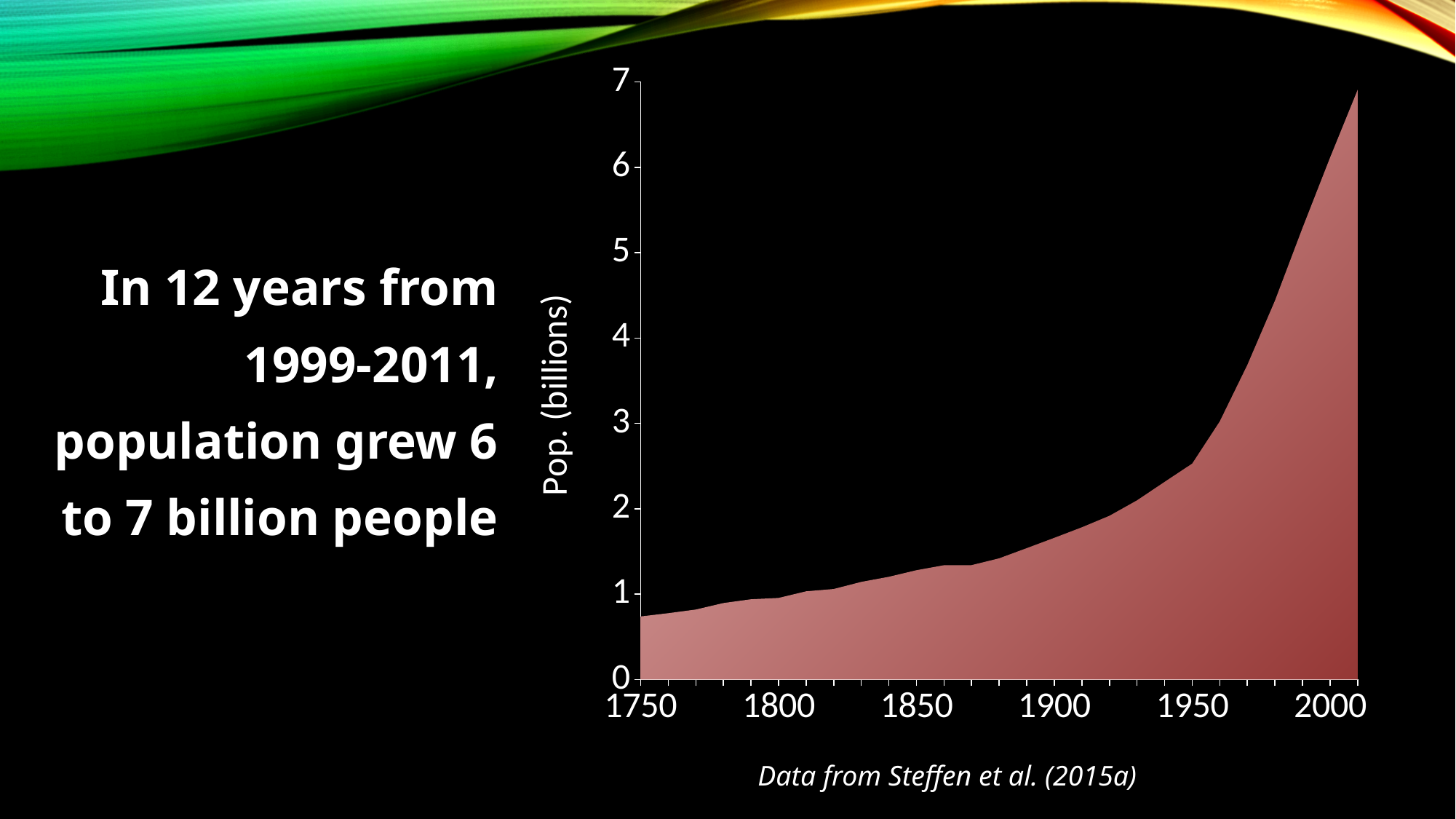
Does the population value rise or fall from 1750 to 2000 along the x axis? rise What is the highest value shown on the y axis? 7 Is the population value for 1850 greater or less than 1 billion? greater Which is larger, the population value for 1950 or for 1850? 1950 Is the population value for 2000 greater or less than 5 billion? greater Is the population value for 1900 greater or less than 2 billion? less What kind of chart is shown on the slide? area chart What is the label of the y axis? Pop. (billions) At which end of the x axis is the population lowest, 1750 or 2000? 1750